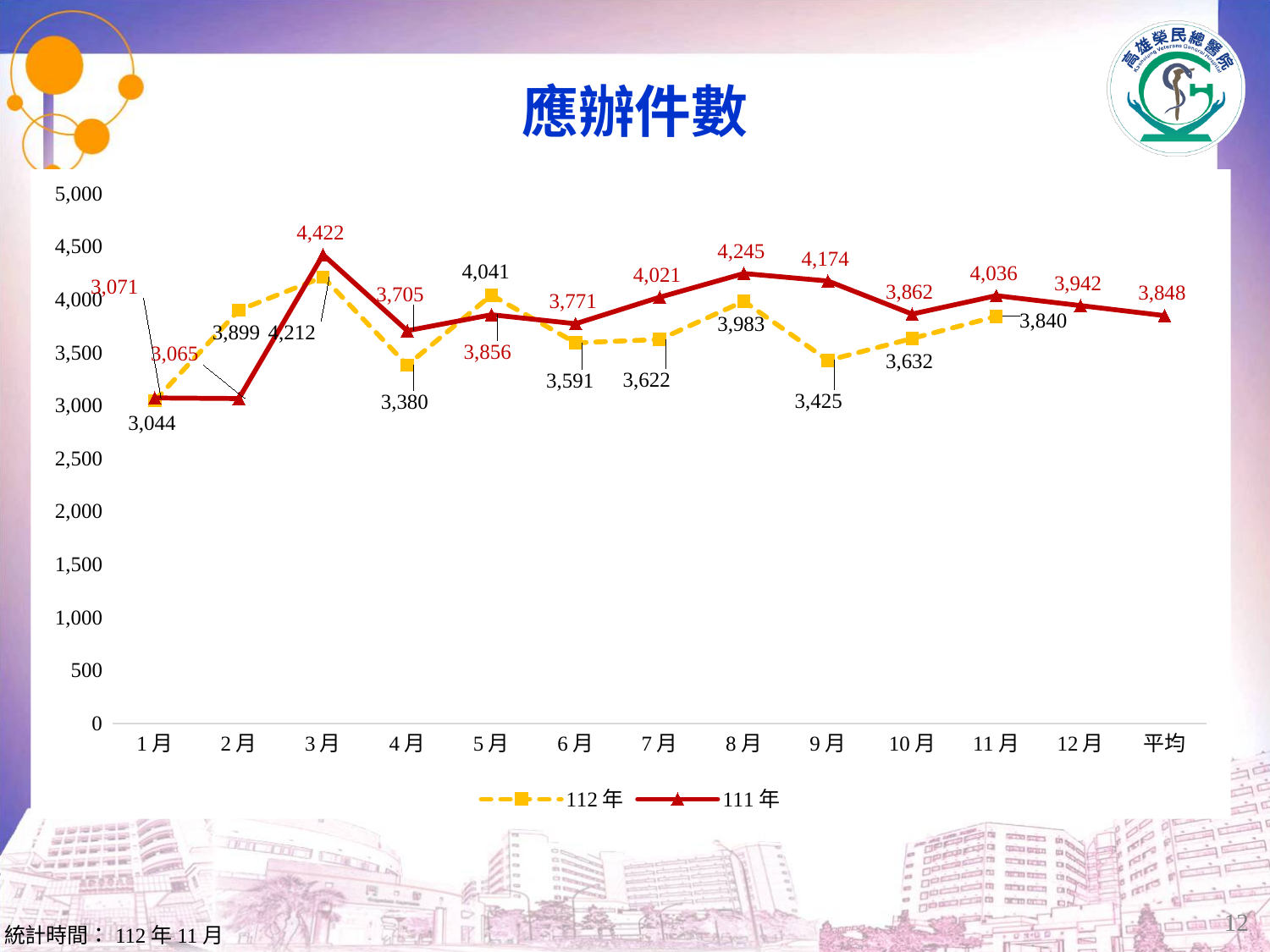
What is the 平均 value for the 111年 series? 3,848 In which month does the 111年 series reach its highest value? 3月 What kind of chart is shown on the slide? line chart What is the value for 111年 in 3月? 4,422 Is the value for 111年 in 8月 greater or less than 4,000? greater How many series does the legend list? 2 What is the difference between the 111年 and 112年 values in 3月? 210 In which month does the 112年 series reach its highest value? 3月 In 2月, which series has the larger value, 112年 or 111年? 112年 What is the difference between the 111年 and 112年 values in 8月? 262 In which month does the 112年 series have its lowest value? 1月 What is the value for 112年 in 5月? 4,041